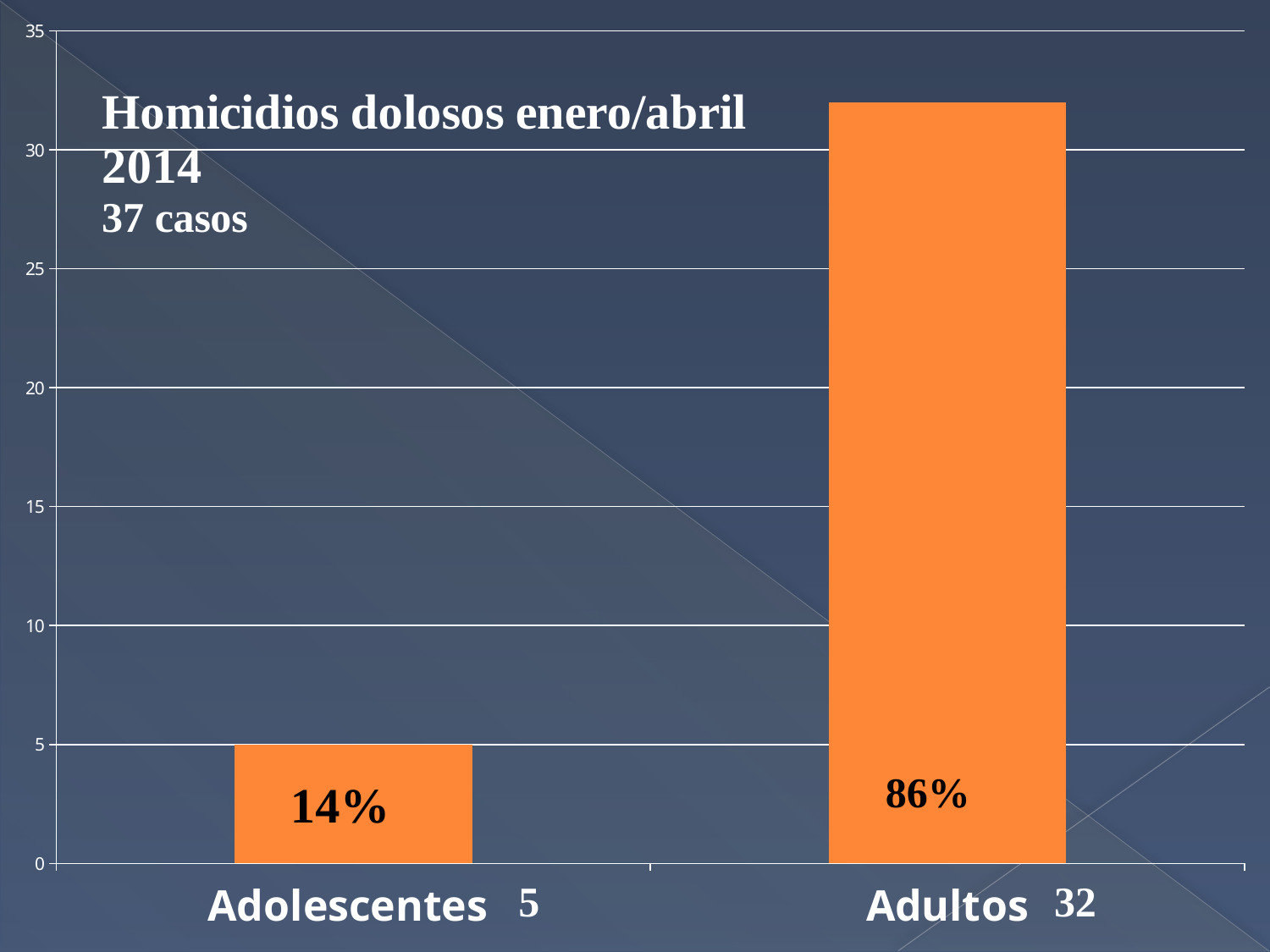
Which category has the highest value? Adultos What is the title of the chart? Homicidios dolosos enero/abril 2014 Which is larger, the value for Adolescentes or the value for Adultos? Adultos What percentage label is shown on the Adolescentes bar? 14% What kind of chart is shown on the slide? bar chart What is the value for Adultos? 32 Which category has the lowest value? Adolescentes How many categories are shown on the x axis? 2 What is the difference between the values for Adultos and Adolescentes? 27 What is the value for Adolescentes? 5 What percentage label is shown on the Adultos bar? 86% Is the value for Adultos greater or less than 30? greater